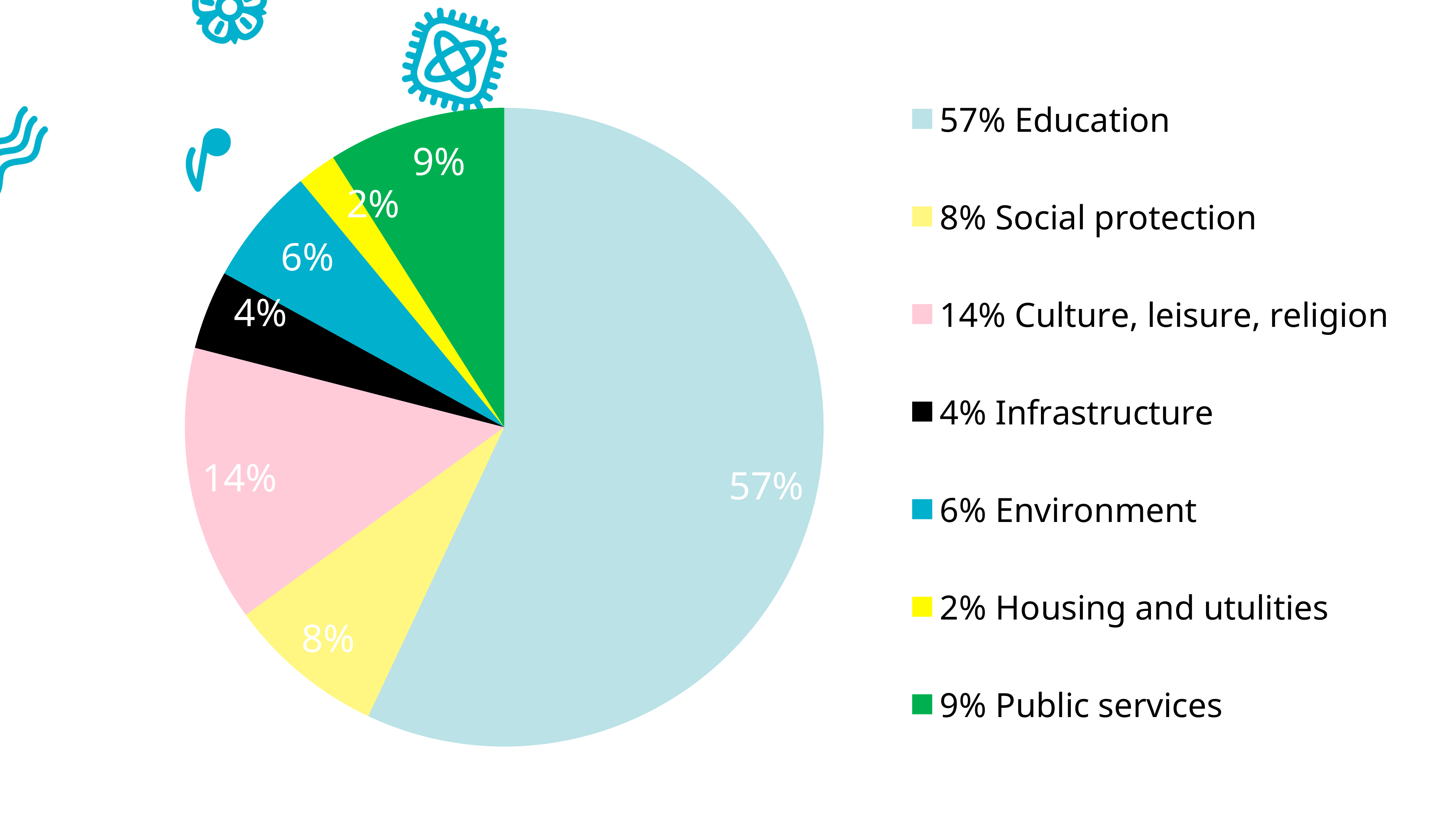
What is the difference between the Environment and Infrastructure shares? 2% What is the value for Environment? 6% Which category has the largest slice? Education What is the value for Culture, leisure, religion? 14% What is the difference between the Education and Culture, leisure, religion shares? 43% Which category has the smallest slice? Housing and utulities Which is larger, Social protection or Public services? Social protection What kind of chart is shown on the slide? pie chart What colour is the Infrastructure slice? black What is the value for Public services? 9% How many categories does the pie chart have? 7 What share of the pie does Education take? 57%